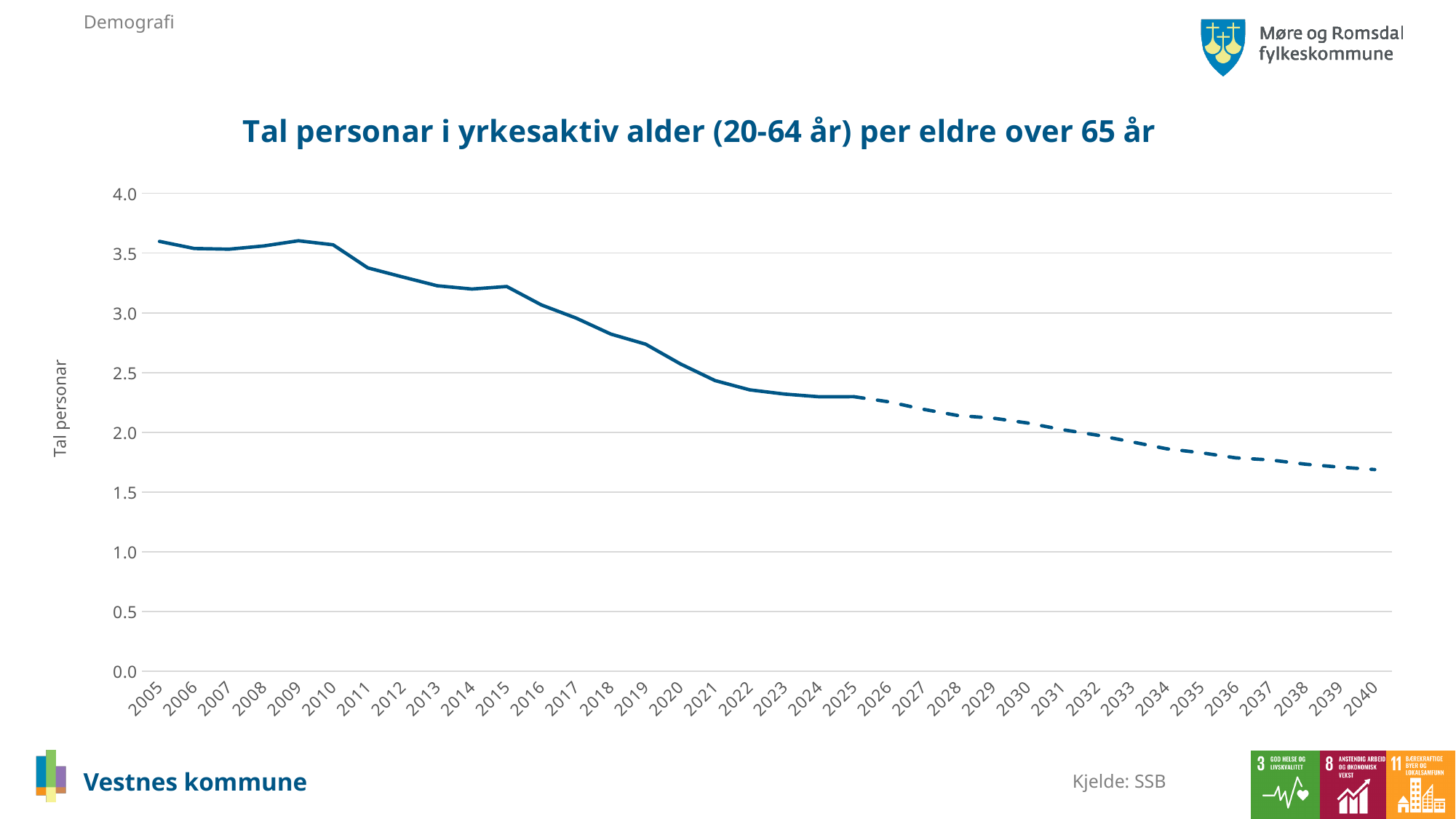
Is the value for 2040 greater or less than 1.5? greater Is the value for 2025 greater or less than 2.5? less How many years are shown along the x axis of the chart? 36 What kind of chart is shown on the slide? line chart Is the value for 2030 greater or less than 2.0? greater Which year has the lowest value on the chart? 2040 Does the value rise or fall overall from 2005 to 2040? fall What is the label on the vertical axis of the chart? Tal personar Which year has the larger value, 2010 or 2020? 2010 What is the title of the chart? Tal personar i yrkesaktiv alder (20-64 år) per eldre over 65 år